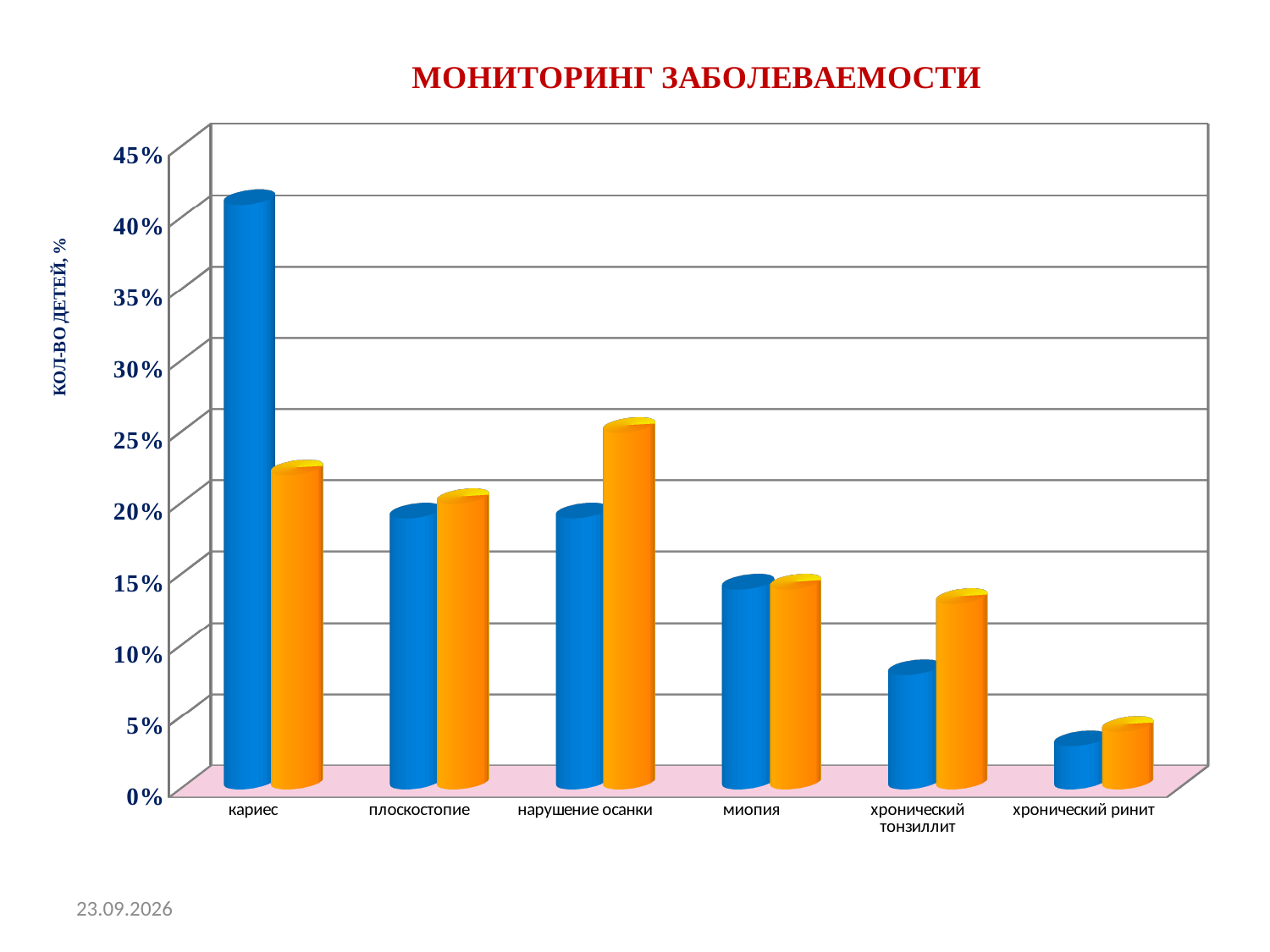
What kind of chart is shown on the slide? bar chart Which category has the highest blue bar? кариес Is the orange bar for хронический тонзиллит greater or less than 10%? greater How many categories are shown on the x axis of the chart? 6 Which category has the lowest blue bar? хронический ринит Is the blue bar for кариес greater or less than 40%? greater Which category has the highest orange bar? нарушение осанки Which category has the lowest orange bar? хронический ринит What is the title of the chart? МОНИТОРИНГ ЗАБОЛЕВАЕМОСТИ For нарушение осанки, which bar is taller, the blue one or the orange one? orange For кариес, which bar is taller, the blue one or the orange one? blue What is the label of the vertical axis? КОЛ-ВО ДЕТЕЙ, %